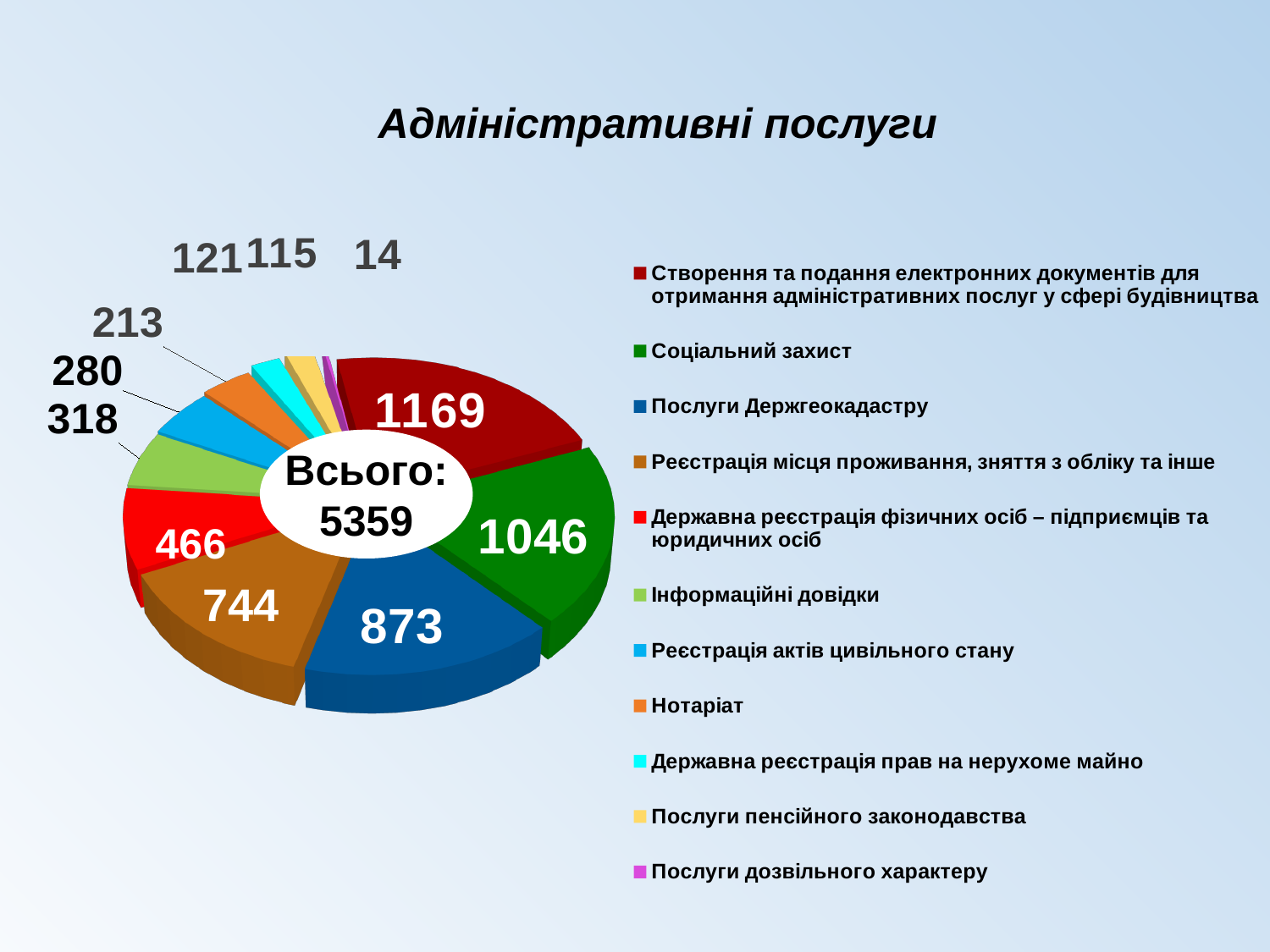
What is the difference between the values for Реєстрація місця проживання, зняття з обліку та інше and Державна реєстрація фізичних осіб – підприємців та юридичних осіб? 278 What is the value for Соціальний захист? 1046 What is the total shown in the centre of the pie? 5359 What is the value for Нотаріат? 213 How many categories does the legend list? 11 Which category has the largest slice? Створення та подання електронних документів для отримання адміністративних послуг у сфері будівництва What type of chart is shown on the slide? Pie chart What is the value for Послуги Держгеокадастру? 873 What is the title of the chart? Адміністративні послуги Which category has the smallest slice? Послуги дозвільного характеру Which is larger: the value for Інформаційні довідки or the value for Реєстрація актів цивільного стану? Інформаційні довідки What share of the total of 5359 does Соціальний захист (1046) represent, to one decimal place? 19.5%